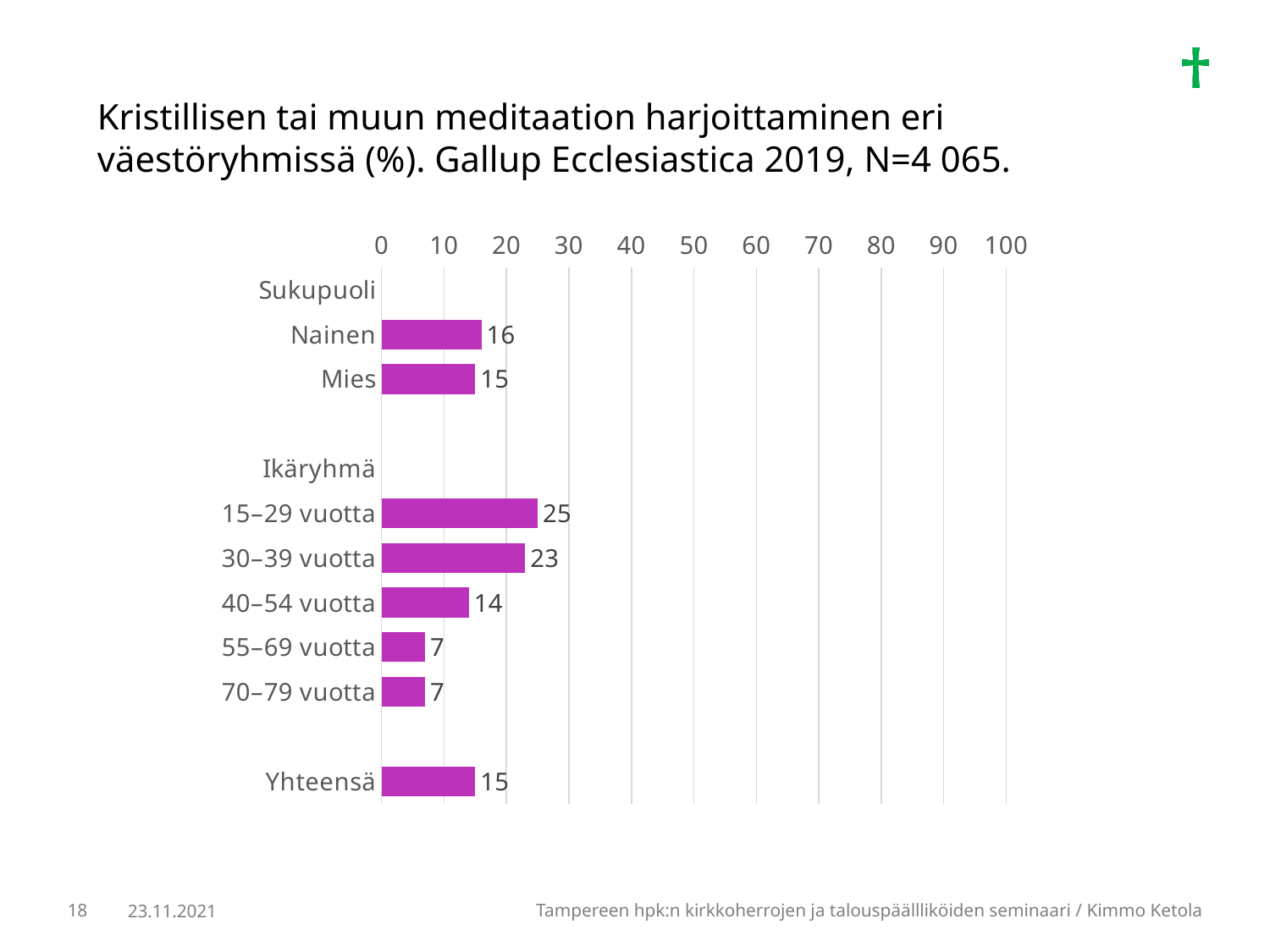
What is the value for 40–54 vuotta? 14 Which category has the lowest value among the age groups? 55–69 vuotta and 70–79 vuotta (both 7) What is the value for Yhteensä? 15 What kind of chart is shown on the slide? Bar chart Which age group has the highest value? 15–29 vuotta What is the difference between the values for Nainen and Mies? 1 Is the value for 15–29 vuotta greater or less than 20? greater Which is larger, the value for 30–39 vuotta or the value for 40–54 vuotta? 30–39 vuotta What is the difference between the values for 15–29 vuotta and 30–39 vuotta? 2 What is the value for 15–29 vuotta? 25 What is the value for Nainen? 16 How many bars with data labels are plotted on the chart? 8